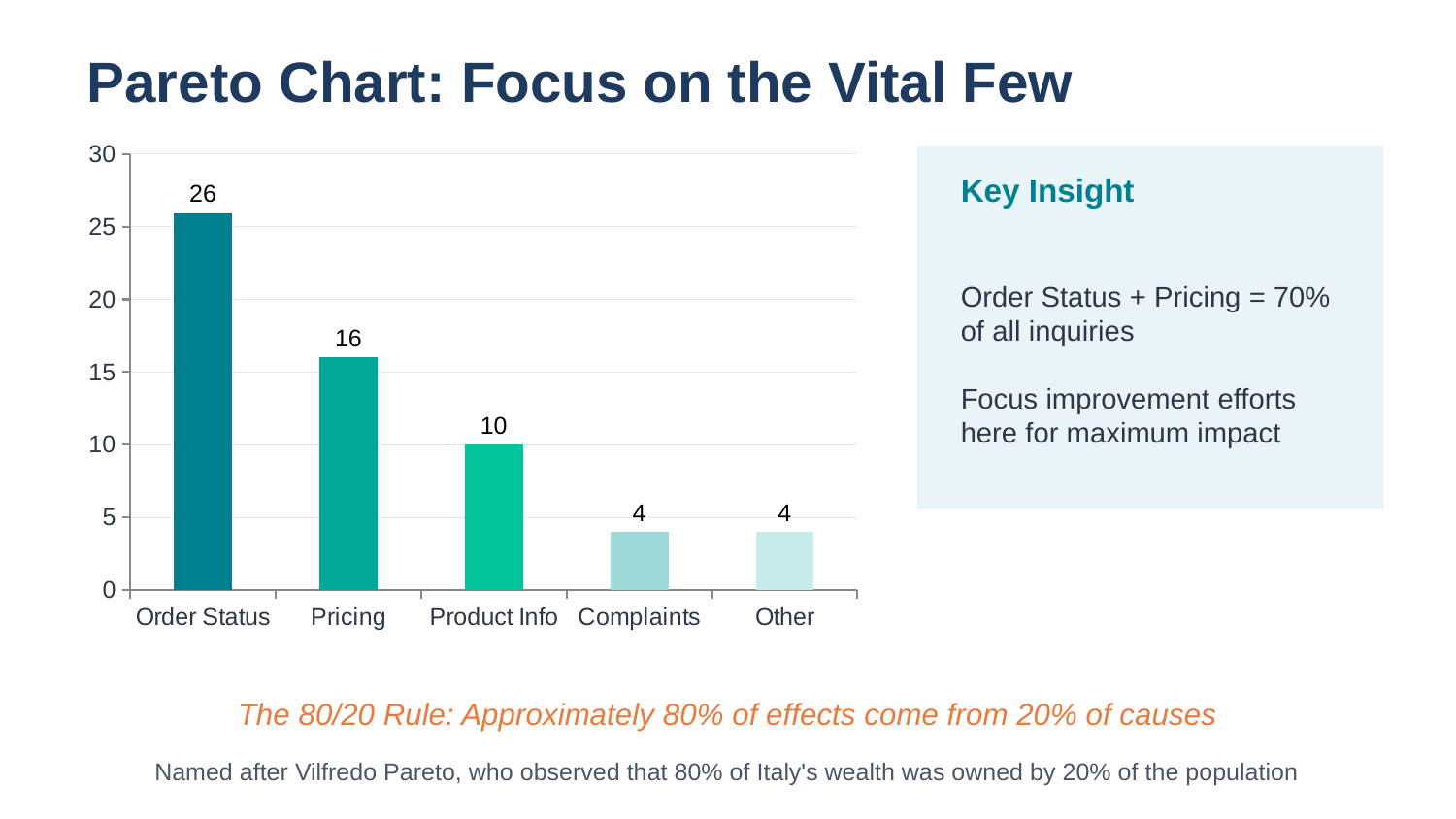
What is the value for Product Info? 10 How many categories are shown on the x axis? 5 Is the value for Order Status greater or less than 25? greater Which category has the highest value? Order Status What is the value for Pricing? 16 What is the value for Order Status? 26 What is the difference between the values for Pricing and Product Info? 6 What kind of chart is shown on the slide? Bar chart Which is larger, the value for Pricing or the value for Product Info? Pricing What is the difference between the values for Order Status and Pricing? 10 Do the values rise or fall from left to right along the x axis? Fall What is the value for Complaints? 4